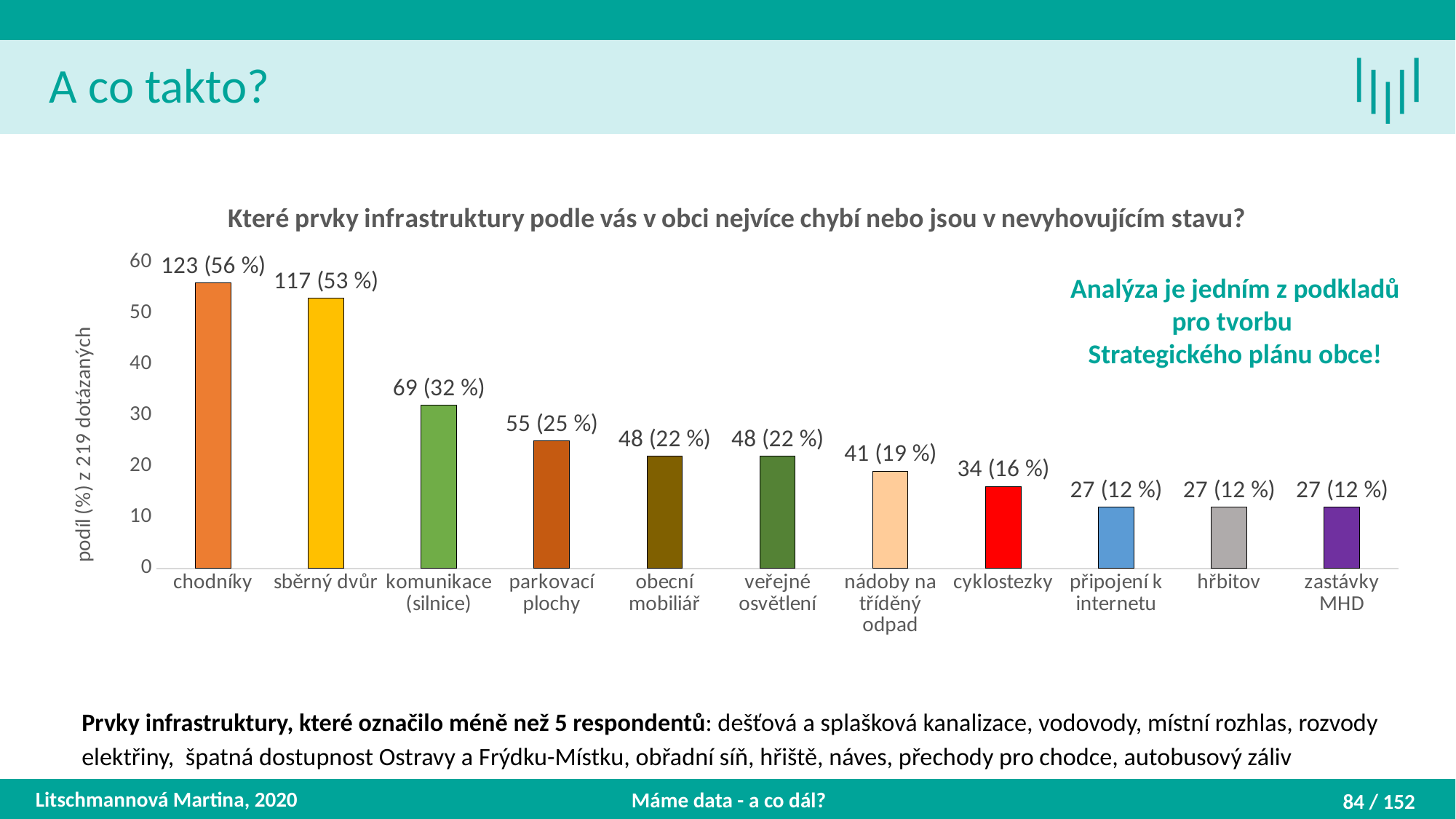
What kind of chart is shown? bar chart Which category has the highest value? chodníky What is the label of the y axis? podíl (%) z 219 dotázaných How many respondents selected cyklostezky? 34 Which has a larger value, komunikace (silnice) or parkovací plochy? komunikace (silnice) How many more respondents selected chodníky than sběrný dvůr? 6 How many categories are shown on the x axis? 11 What is the data label shown for sběrný dvůr? 117 (53 %) What is the data label shown for chodníky? 123 (56 %) Is the value for nádoby na tříděný odpad greater or less than 20 on the y axis? less Do the values rise or fall from left to right along the x axis? fall What percentage is shown for komunikace (silnice)? 32 %